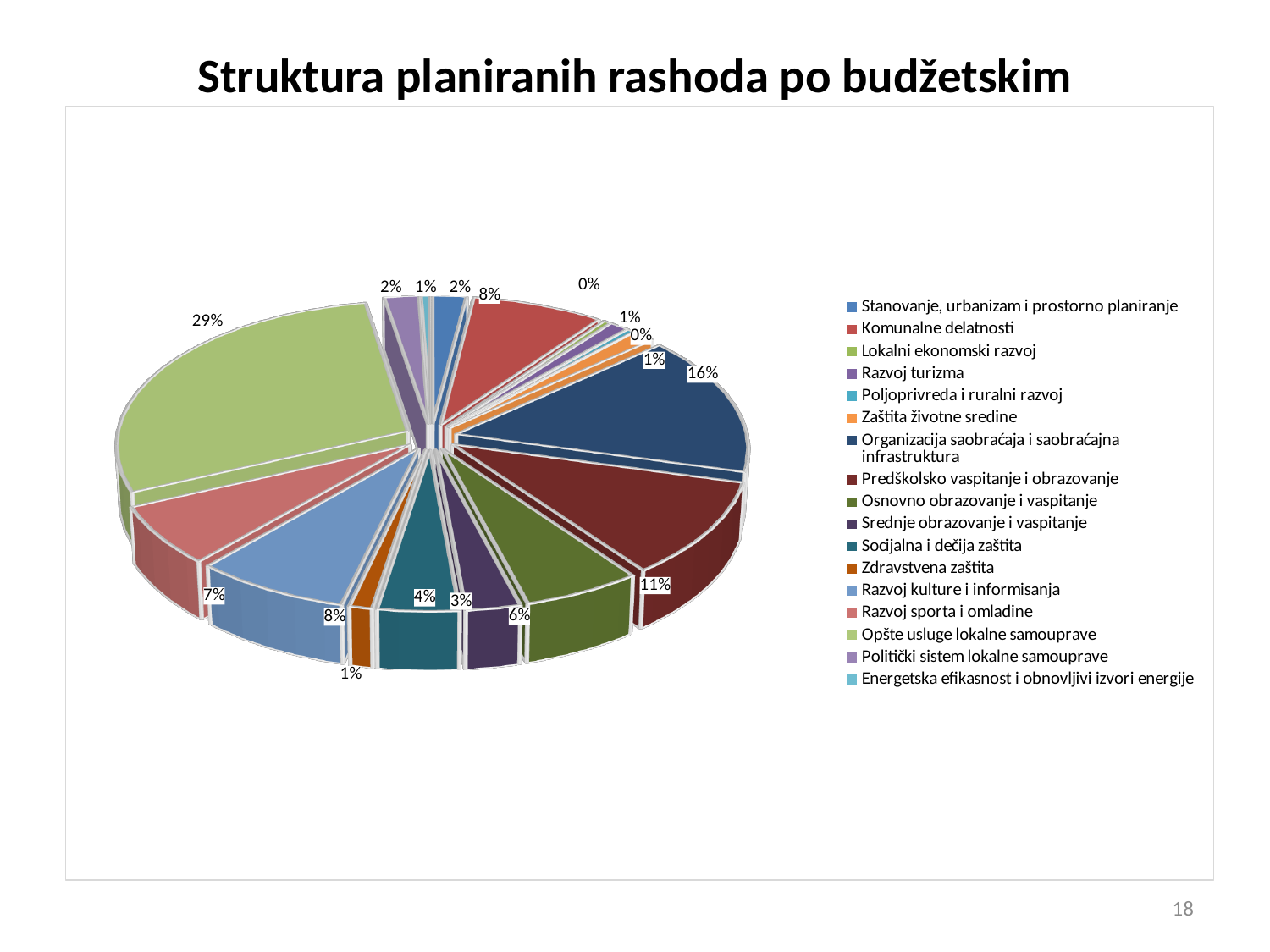
Which is larger: the share for Organizacija saobraćaja i saobraćajna infrastruktura or the share for Predškolsko vaspitanje i obrazovanje? Organizacija saobraćaja i saobraćajna infrastruktura How many categories does the legend list? 17 Which category has the largest share of the pie? Opšte usluge lokalne samouprave What share is shown for Osnovno obrazovanje i vaspitanje? 6% What share is shown for Organizacija saobraćaja i saobraćajna infrastruktura? 16% What share of planned expenditure goes to Opšte usluge lokalne samouprave? 29% What is the title of the slide? Struktura planiranih rashoda po budžetskim What share is shown for Socijalna i dečija zaštita? 4% What share is shown for Komunalne delatnosti? 8% What share is shown for Predškolsko vaspitanje i obrazovanje? 11% What is the difference in percentage points between the share for Opšte usluge lokalne samouprave and the share for Organizacija saobraćaja i saobraćajna infrastruktura? 13 percentage points What kind of chart is shown on the slide? pie chart